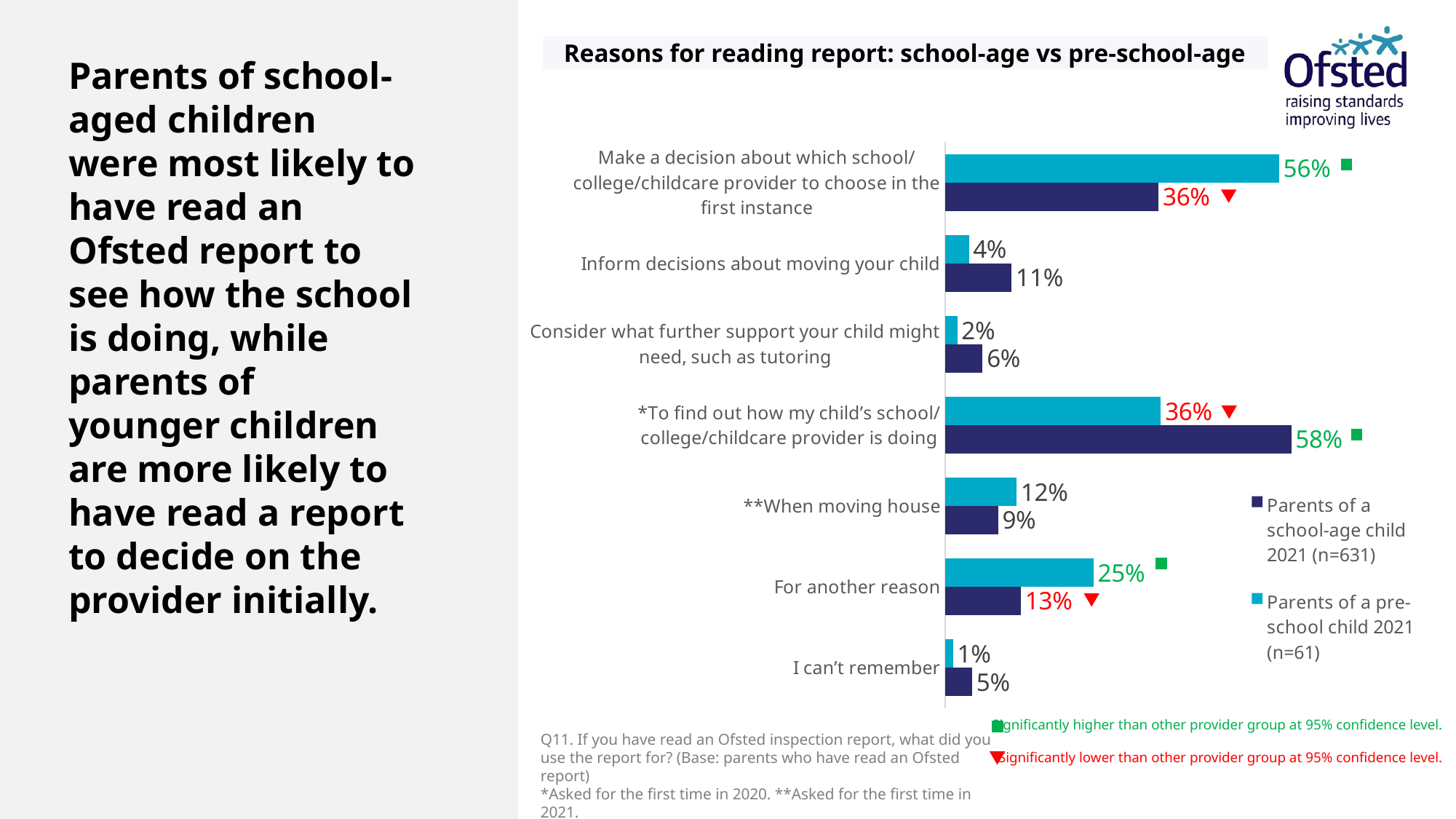
Which reason has the lowest value for parents of a pre-school child? I can't remember What is the sample size (n) for parents of a pre-school child 2021 shown in the legend? n=61 For 'When moving house', which group has the larger value: parents of a school-age child or parents of a pre-school child? Parents of a pre-school child How many reasons (categories) are shown in the chart? 7 What percentage of parents of a pre-school child read the report to make a decision about which school/college/childcare provider to choose in the first instance? 56% What is the title of the chart? Reasons for reading report: school-age vs pre-school-age What is the difference between parents of a school-age child and parents of a pre-school child for 'To find out how my child's school/college/childcare provider is doing'? 22 percentage points Which reason has the highest value for parents of a pre-school child? Make a decision about which school/college/childcare provider to choose in the first instance What percentage of parents of a school-age child read the report to find out how their child's school/college/childcare provider is doing? 58% How many series does the legend list? 2 What type of chart is shown on the slide? Bar chart What is the value for 'For another reason' among parents of a school-age child? 13%